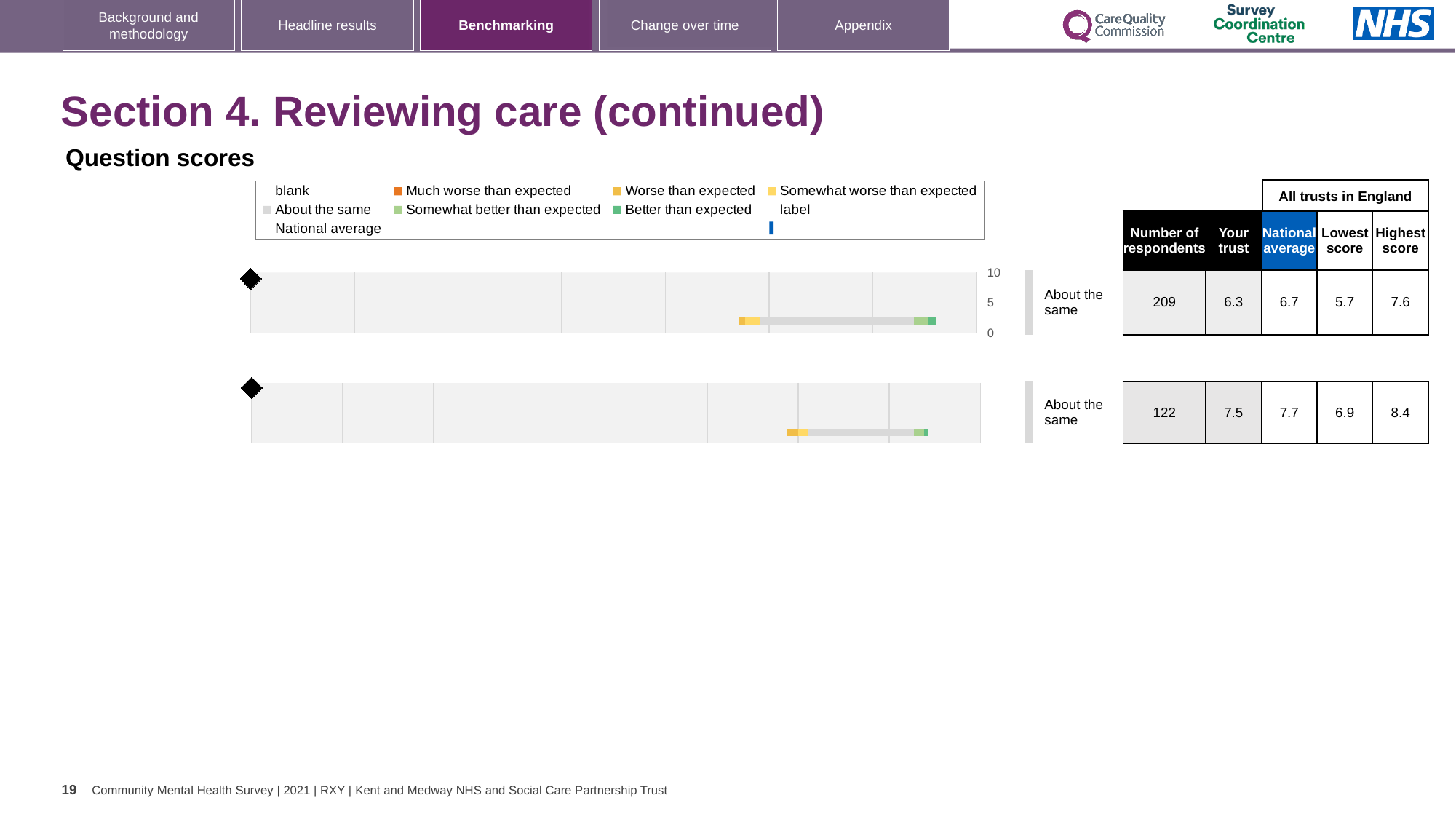
What kind of chart is used to show the question scores on this slide? bar chart What is the highest score among all trusts in England for the bottom question score bar? 8.4 For the top question score bar, what is the difference between the highest score and the lowest score? 1.9 What is the national average for the bottom question score bar? 7.7 What is the 'Your trust' score for the top question score bar? 6.3 What is the number of respondents for the top question score bar? 209 For the top question score bar, which is larger: the 'Your trust' score or the national average? National average How many question score bars are shown on the slide? 2 What benchmark category is shown next to the bottom question score bar? About the same For the bottom question score bar, what is the difference between the national average and the 'Your trust' score? 0.2 What is the highest value shown on the score axis of the top chart? 10